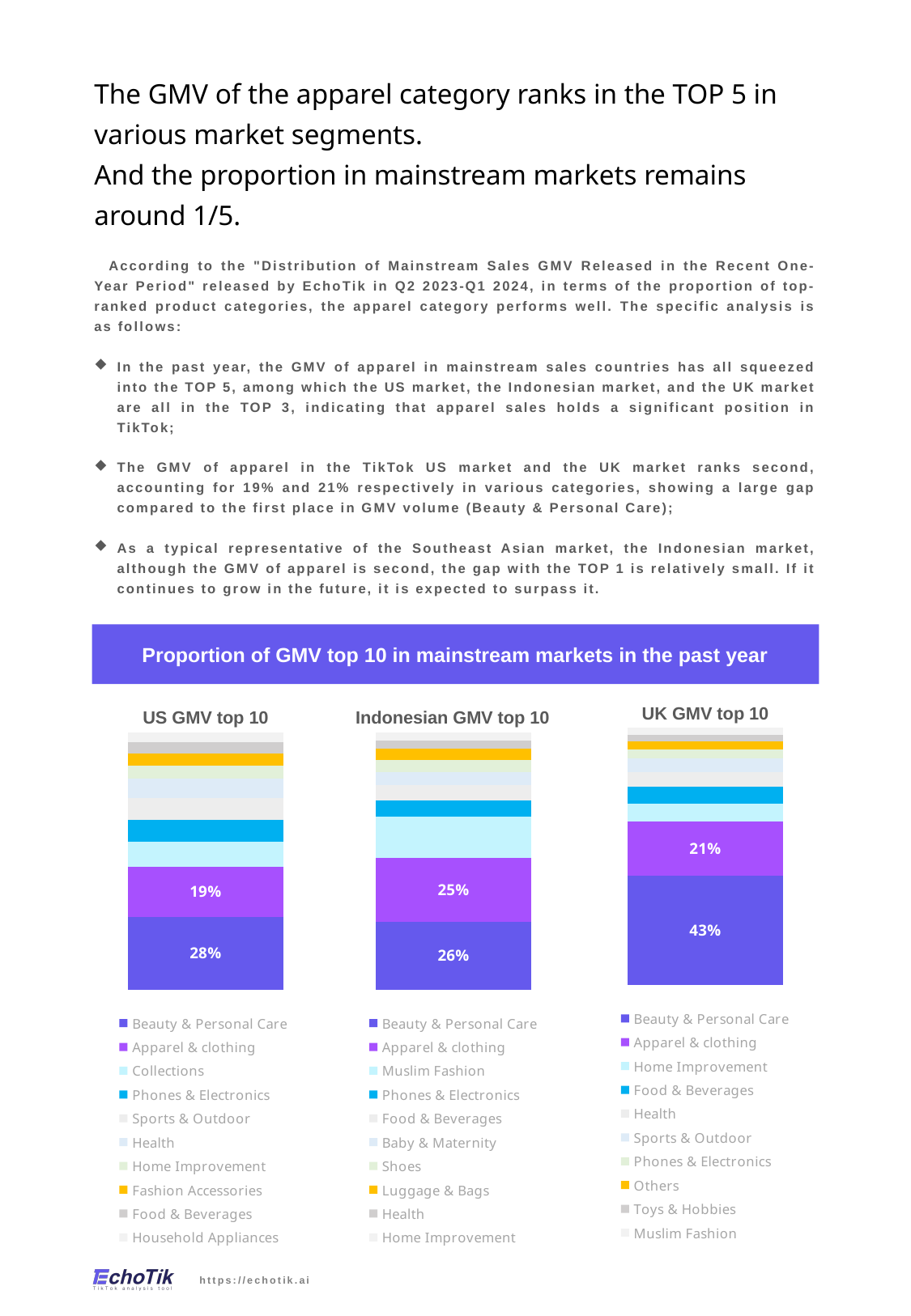
What kind of chart is the UK GMV top 10 chart? Stacked bar chart In the UK GMV top 10 chart, what is the value for Apparel & clothing? 21% In the UK GMV top 10 chart, what is the value for Beauty & Personal Care? 43% In the Indonesian GMV top 10 chart, what is the value for Apparel & clothing? 25% What is the title shown in the banner above the three charts? Proportion of GMV top 10 in mainstream markets in the past year How many categories does the legend of the Indonesian GMV top 10 chart list? 10 Which market's chart shows the larger value for Apparel & clothing, the US GMV top 10 or the UK GMV top 10? UK GMV top 10 In the US GMV top 10 chart, what is the value for Apparel & clothing? 19% In the UK GMV top 10 chart, what is the difference between Beauty & Personal Care and Apparel & clothing? 22% In the US GMV top 10 chart, which category has the largest share? Beauty & Personal Care In the Indonesian GMV top 10 chart, what is the difference between Beauty & Personal Care and Apparel & clothing? 1% In the US GMV top 10 chart, what is the value for Beauty & Personal Care? 28%